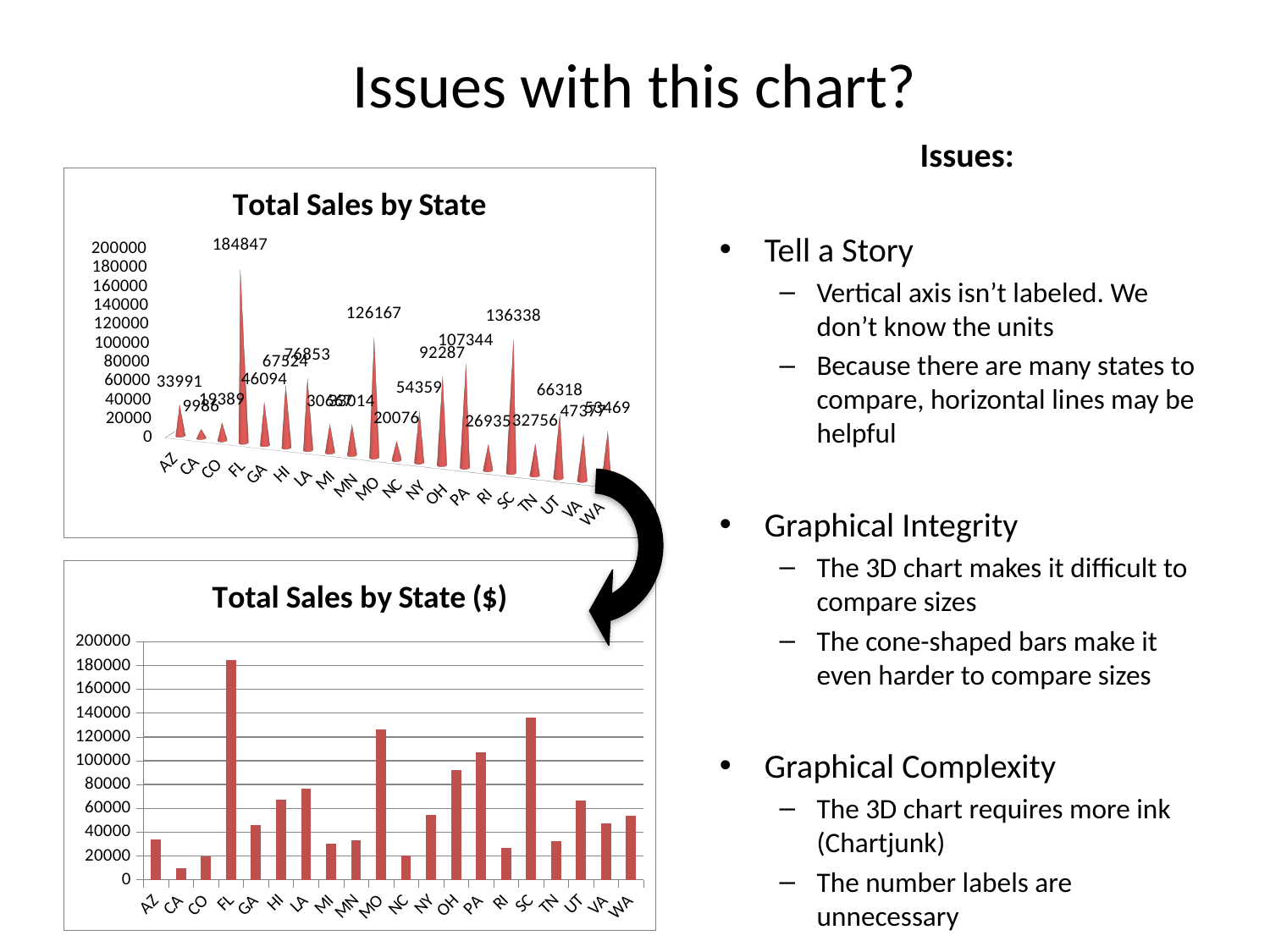
In the top chart, Total Sales by State, what is the value for MO? 126167 In the top chart, Total Sales by State, what is the value for NC? 20076 In the top chart, Total Sales by State, which is larger, the value for HI or the value for LA? LA How many states are shown in the bottom chart, Total Sales by State ($)? 20 In the bottom chart, Total Sales by State ($), is the value for OH greater or less than 80000? greater In the top chart, Total Sales by State, which state has the highest total sales? FL In the top chart, Total Sales by State, what is the difference between the values for SC and PA? 28994 What kind of chart is the bottom chart, Total Sales by State ($)? bar chart In the top chart, Total Sales by State, which state has the lowest total sales? CA In the bottom chart, Total Sales by State ($), which is larger, the value for PA or the value for OH? PA In the top chart, Total Sales by State, what is the value for FL? 184847 What is the title of the bottom chart? Total Sales by State ($)